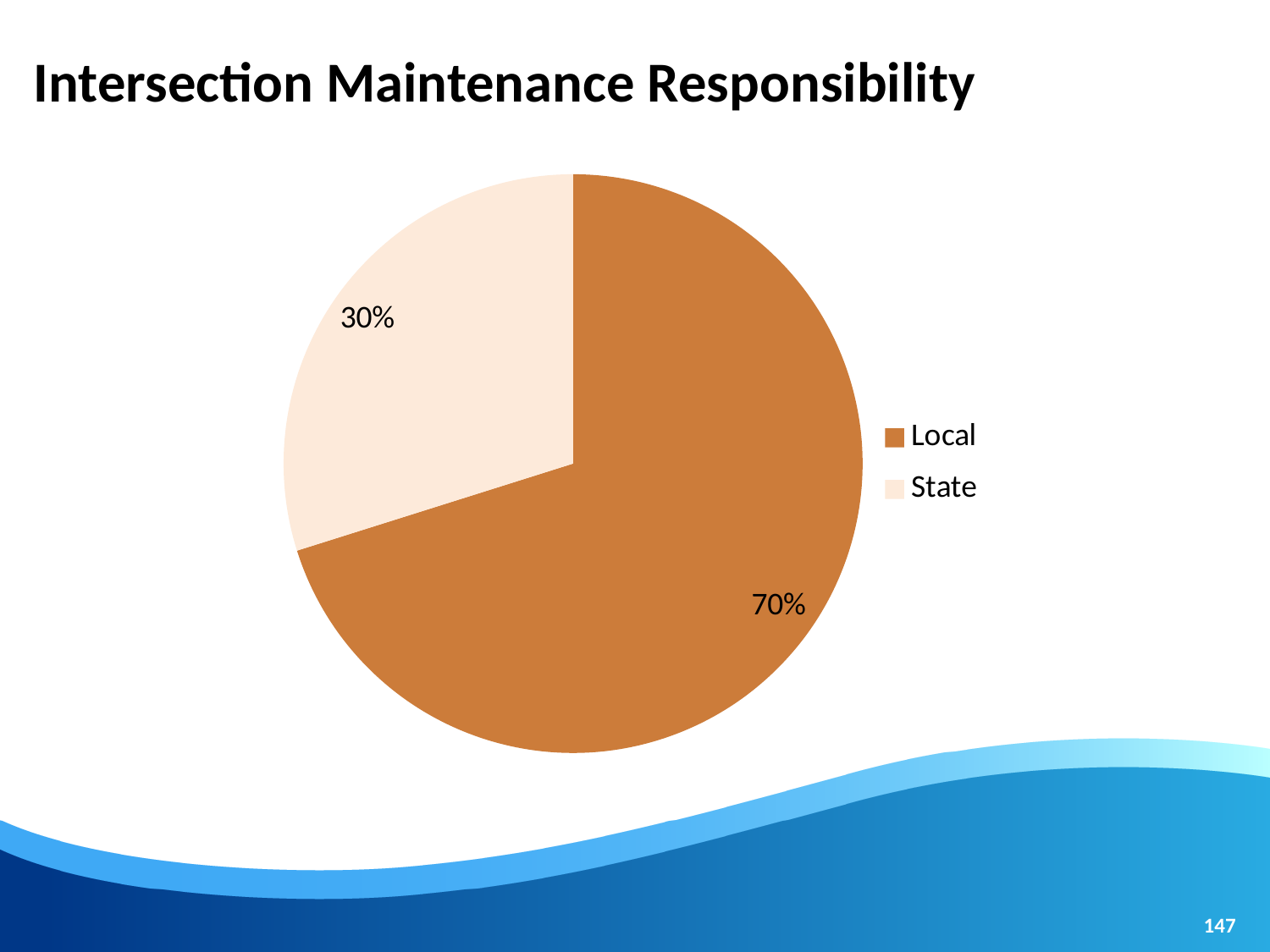
What is the title of the slide? Intersection Maintenance Responsibility What share of the pie does State account for? 30% How many slices does the pie chart have? 2 What is the difference in percentage points between the Local and State slices? 40 percentage points Which is larger, the Local slice or the State slice? Local What kind of chart is shown on the slide? Pie chart Is the value for State greater or less than 50%? less What share of the pie does Local account for? 70% Which category has the smallest slice of the pie? State Which category is shown in the darker orange colour? Local Which category has the largest slice of the pie? Local How many entries does the legend list? 2